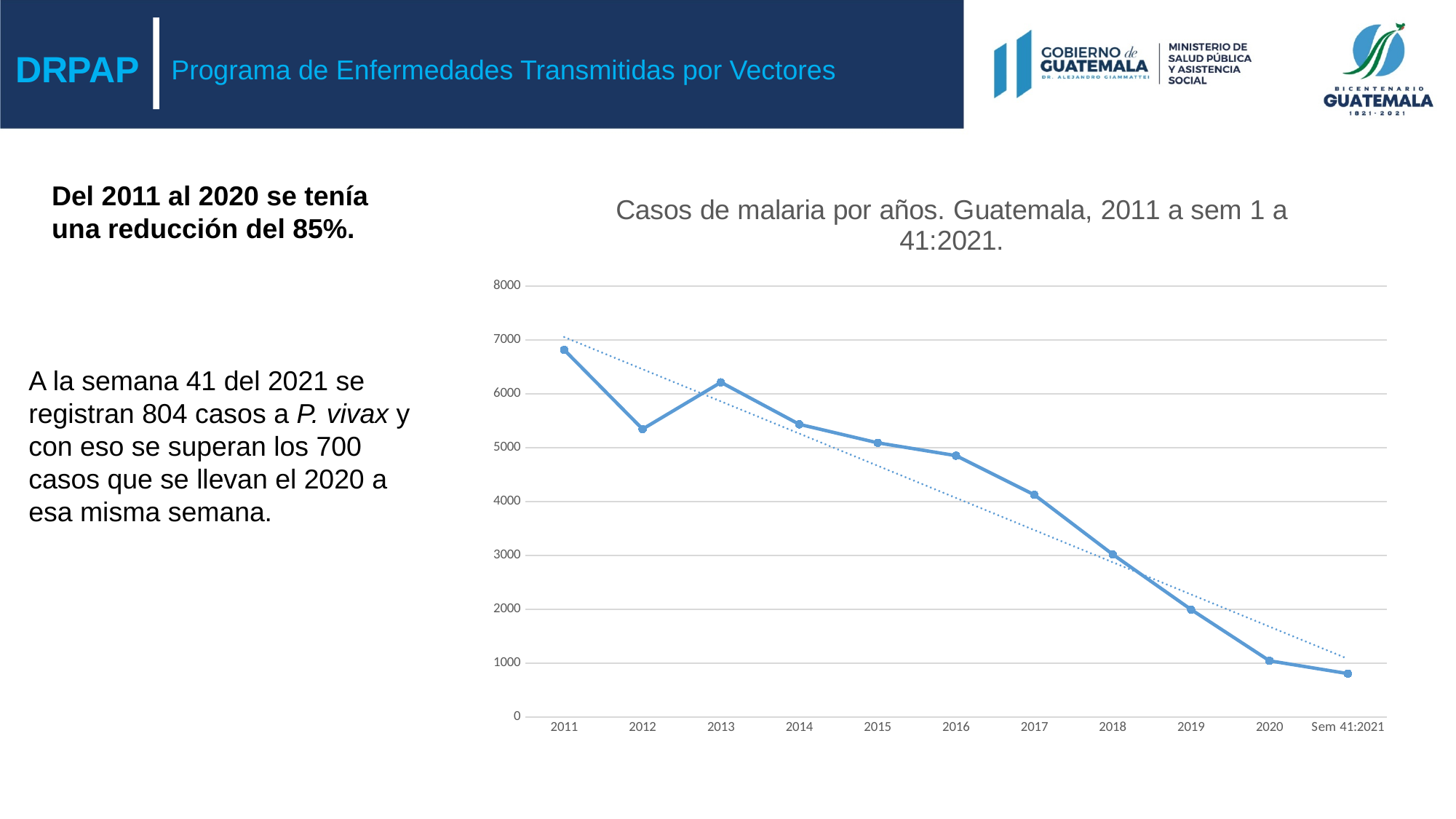
Is the value for 2019 greater or less than 3000? less What is the title of the chart? Casos de malaria por años. Guatemala, 2011 a sem 1 a 41:2021. Do the values generally rise or fall from 2011 to Sem 41:2021? fall Is the value for 2012 greater or less than 5000? greater Which has the larger value, 2012 or 2013? 2013 Is the value for 2017 greater or less than 5000? less Which category has the lowest value in the chart? Sem 41:2021 Which year has the highest number of malaria cases in the chart? 2011 How many points are plotted along the x axis of the chart? 11 What kind of chart is shown on the slide? line chart